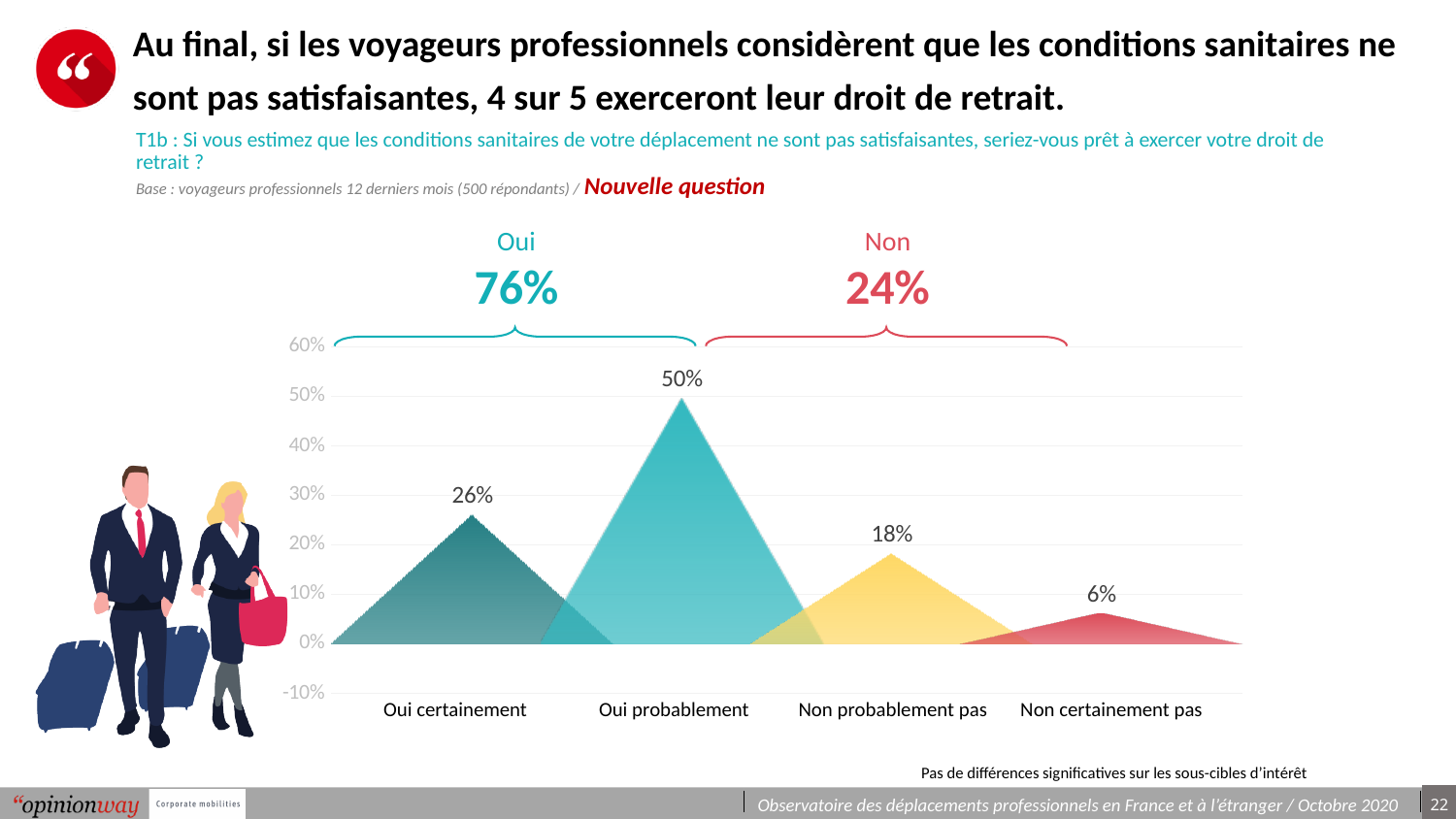
Is the value for 'Oui probablement' greater or less than 40%? greater Which category has the lowest value? Non certainement pas What is the value for 'Non certainement pas'? 6% What is the value for 'Non probablement pas'? 18% What is the combined total shown for the 'Non' answers? 24% How many categories are shown on the x axis? 4 Which is larger, 'Oui certainement' or 'Non probablement pas'? Oui certainement What is the value for 'Oui probablement'? 50% What is the combined total shown for the 'Oui' answers? 76% What is the value for 'Oui certainement'? 26% What is the difference between 'Oui probablement' and 'Oui certainement'? 24% Which category has the highest value? Oui probablement